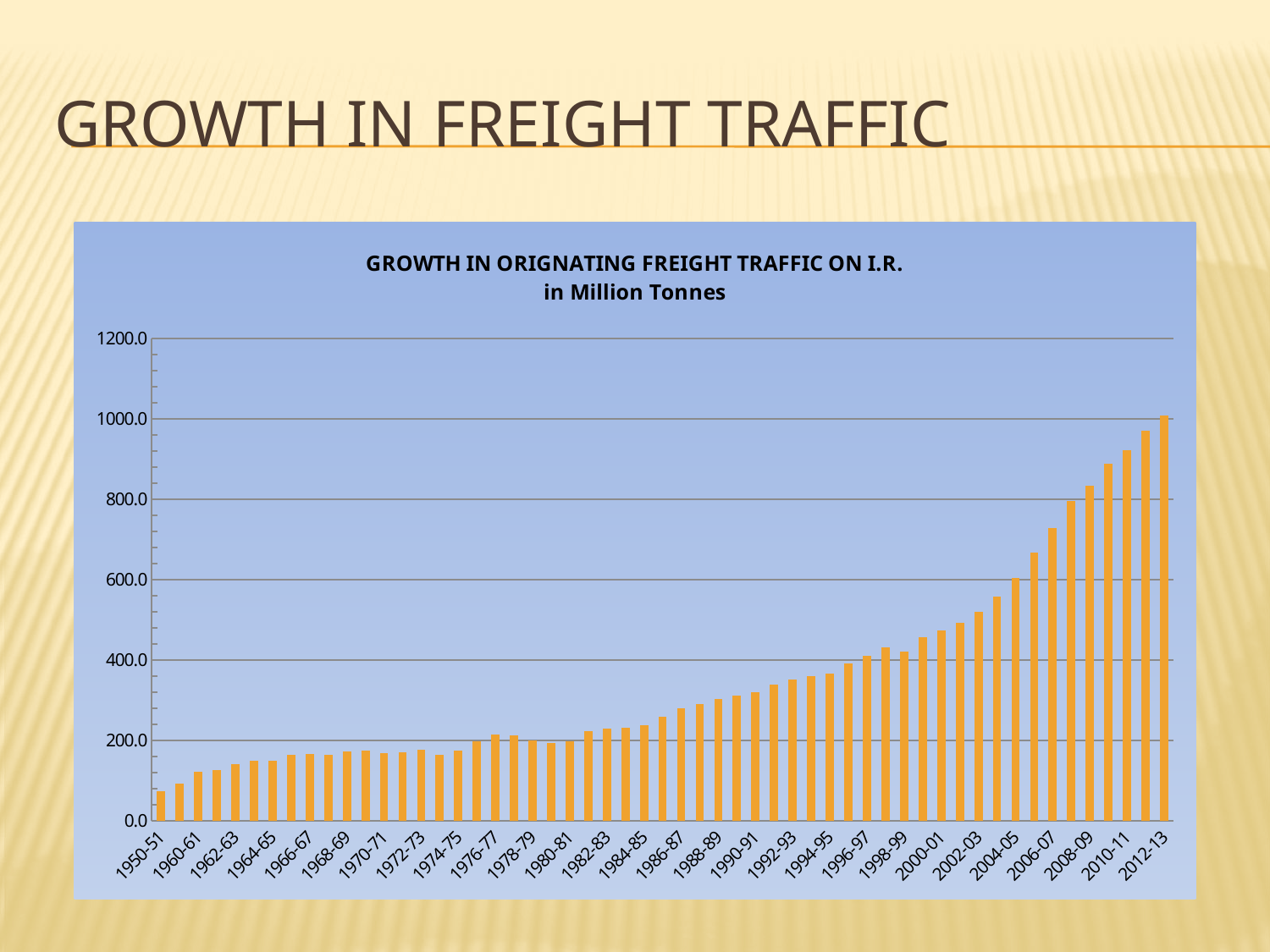
Is the value for 2000-01 greater or less than 400? greater Is the value for 1950-51 greater or less than 200? less What kind of chart is shown on the slide? bar chart Which year has the lowest originating freight traffic? 1950-51 Which year has the highest originating freight traffic? 2012-13 Which year has the larger freight traffic value, 2010-11 or 1990-91? 2010-11 Is the value for 1970-71 greater or less than 200? less In what unit is freight traffic measured in this chart? Million Tonnes Do the freight traffic values generally rise or fall from 1950-51 to 2012-13? rise